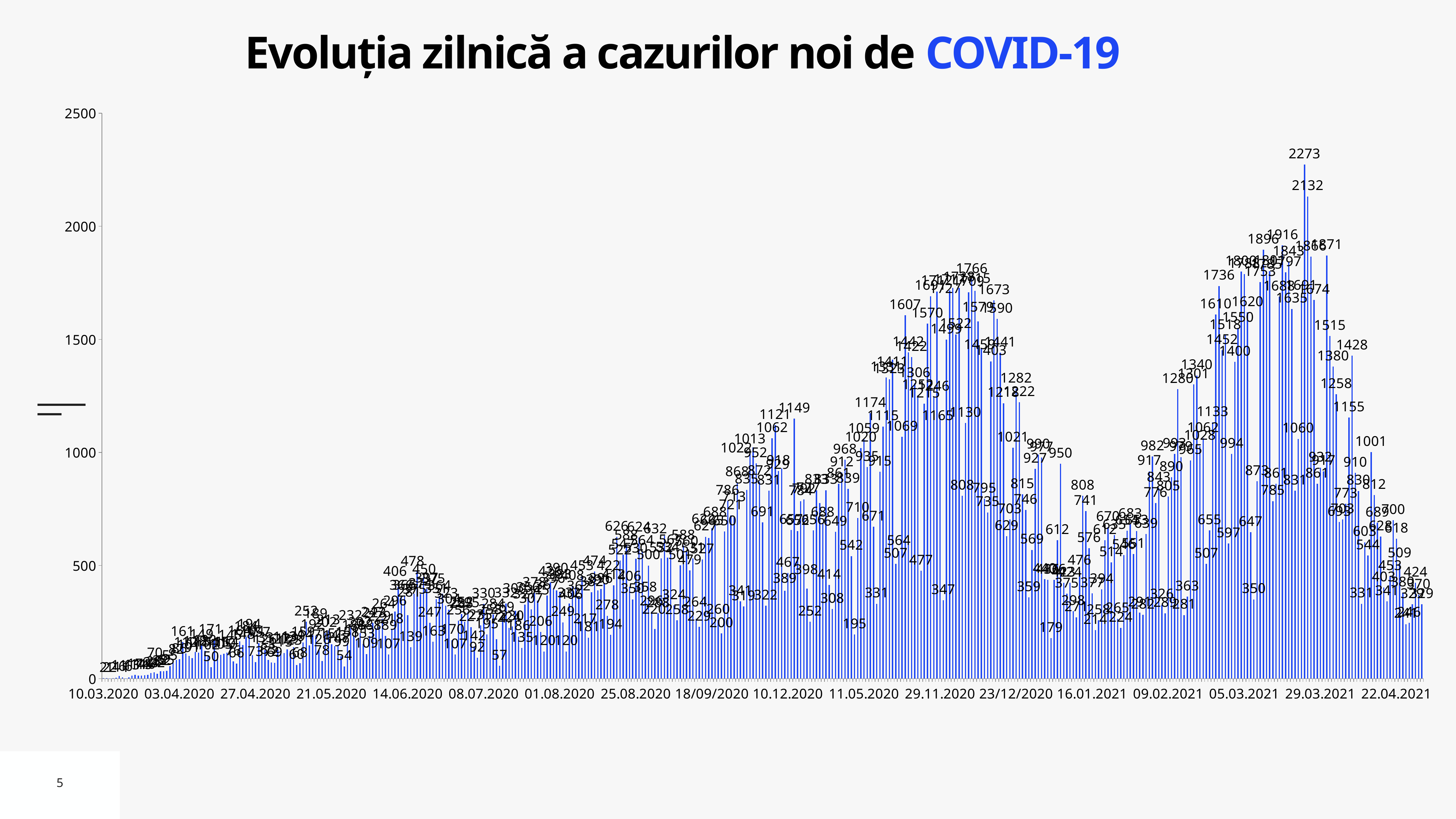
What kind of chart is shown on the slide? bar chart What is the highest value shown on the y axis? 2500 Is the tallest bar on the chart greater or less than 2000? greater Overall, do the daily values rise or fall from the start of the x axis to the end? rise Is the value for the first date, 10.03.2020, greater or less than 500? less What is the title of the chart? Evoluția zilnică a cazurilor noi de COVID-19 Which is higher: the tallest bar near 29.03.2021 or the tallest bar near 29.11.2020? the tallest bar near 29.03.2021 What is the difference between the two highest labelled values, 2273 and 2132? 141 What is the last date label shown on the x axis? 22.04.2021 What is the second-highest daily value labelled on the chart, next to the 2273 peak? 2132 How many date labels are shown along the x axis? 18 What is the highest daily value labelled on the chart? 2273